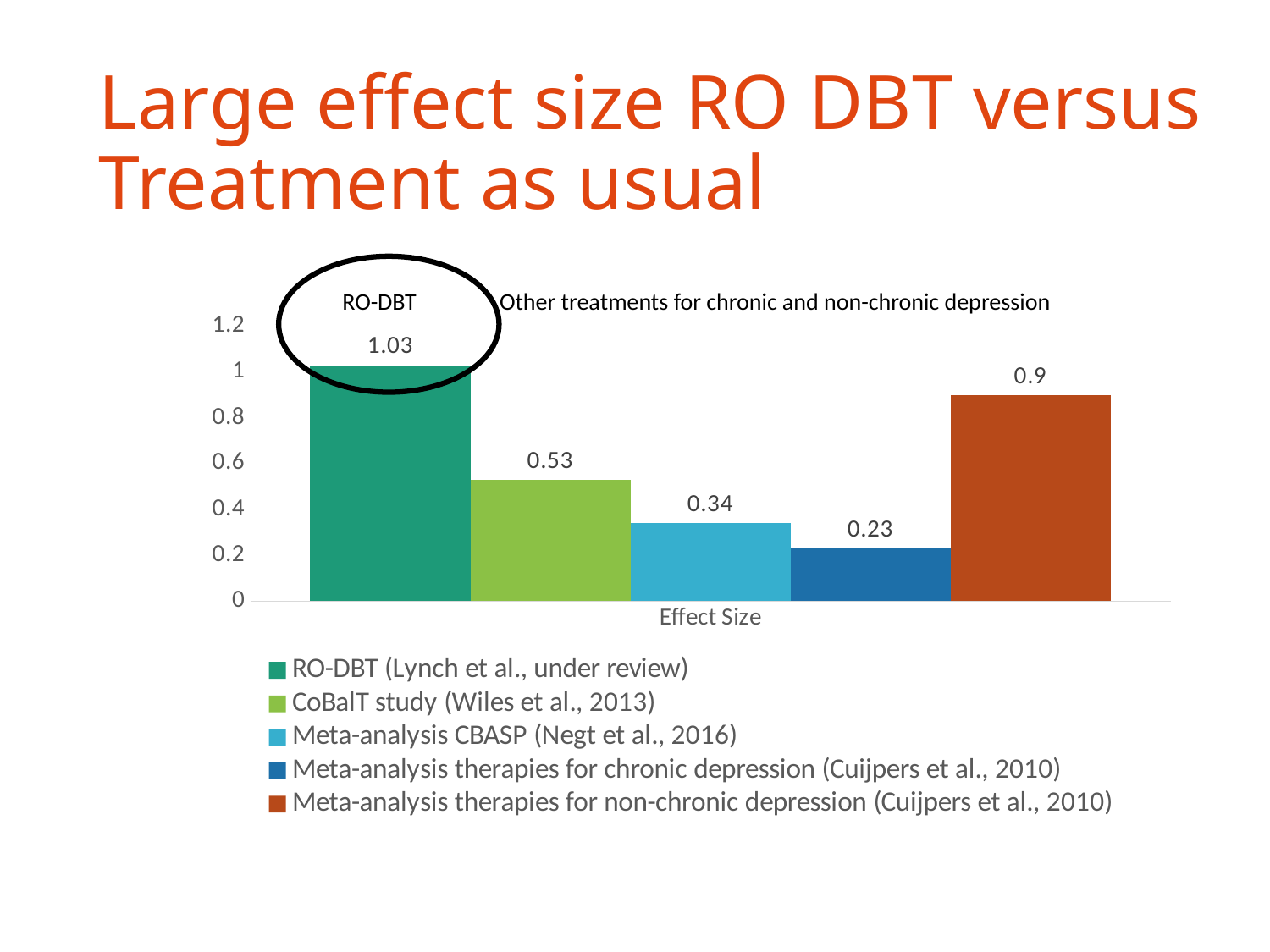
What is the difference between the effect size for RO-DBT and the effect size for the CoBalT study? 0.5 What is the label on the x axis of the chart? Effect Size How many series does the legend list? 5 What is the effect size for Meta-analysis therapies for non-chronic depression (Cuijpers et al., 2010)? 0.9 Is the effect size for Meta-analysis therapies for non-chronic depression greater or less than 1? less What is the effect size for Meta-analysis CBASP (Negt et al., 2016)? 0.34 Which series has the highest effect size? RO-DBT (Lynch et al., under review) Which is larger: the effect size for Meta-analysis CBASP or for Meta-analysis therapies for chronic depression? Meta-analysis CBASP Which series has the lowest effect size? Meta-analysis therapies for chronic depression (Cuijpers et al., 2010) What kind of chart is shown on the slide? bar chart What is the effect size for the CoBalT study (Wiles et al., 2013)? 0.53 What is the effect size for RO-DBT (Lynch et al., under review)? 1.03